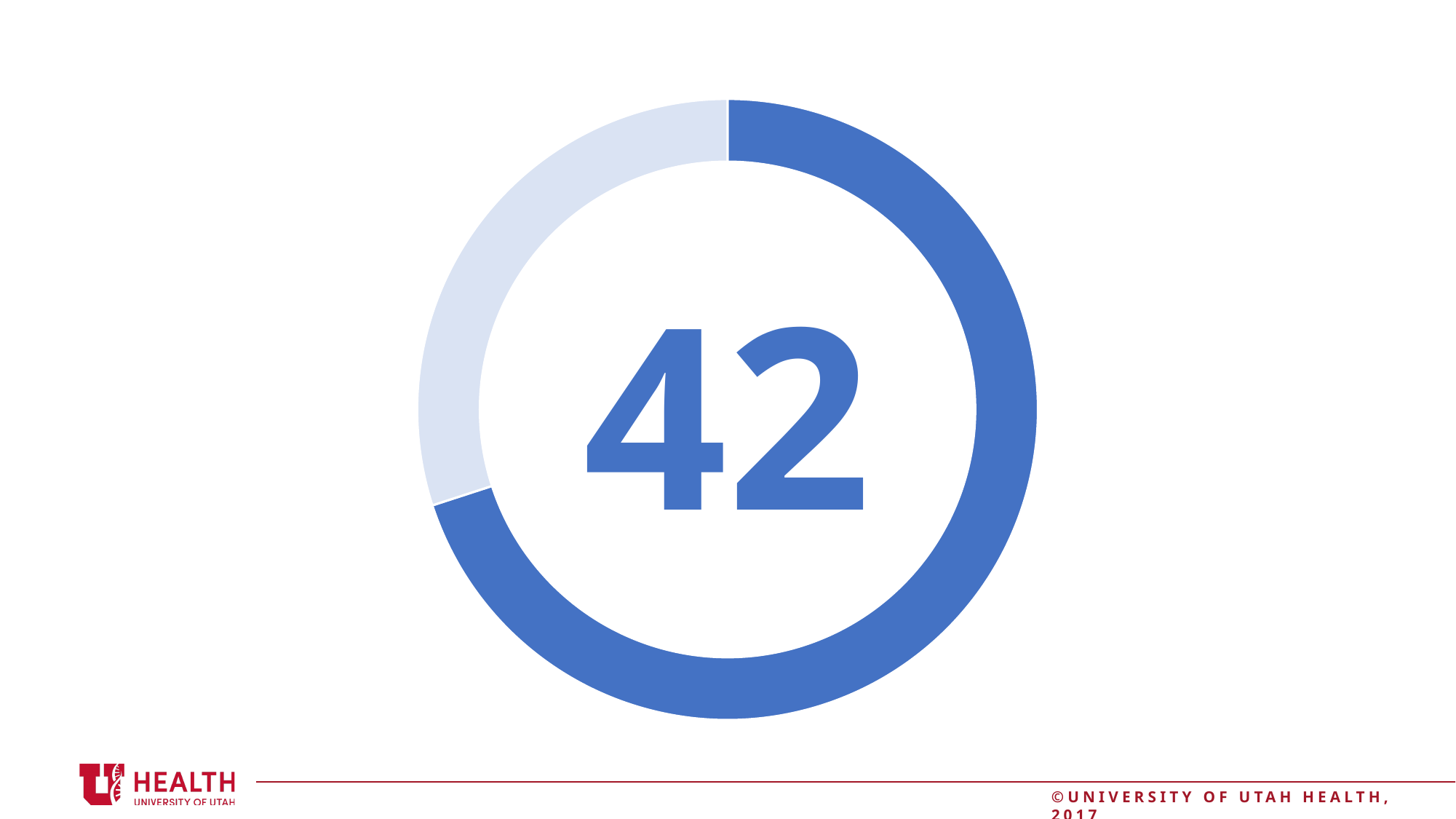
Does the light blue segment cover more or less than half of the donut ring? less What number is displayed in the centre of the donut chart? 42 Does the dark blue segment cover more or less than half of the donut ring? more What kind of chart is shown on the slide? donut chart Which colour segment takes up the smallest share of the donut chart? light blue Which segment of the donut chart is larger, the dark blue one or the light blue one? dark blue Does the donut chart have a legend? No Which colour segment takes up the largest share of the donut chart? dark blue How many segments does the donut chart have? 2